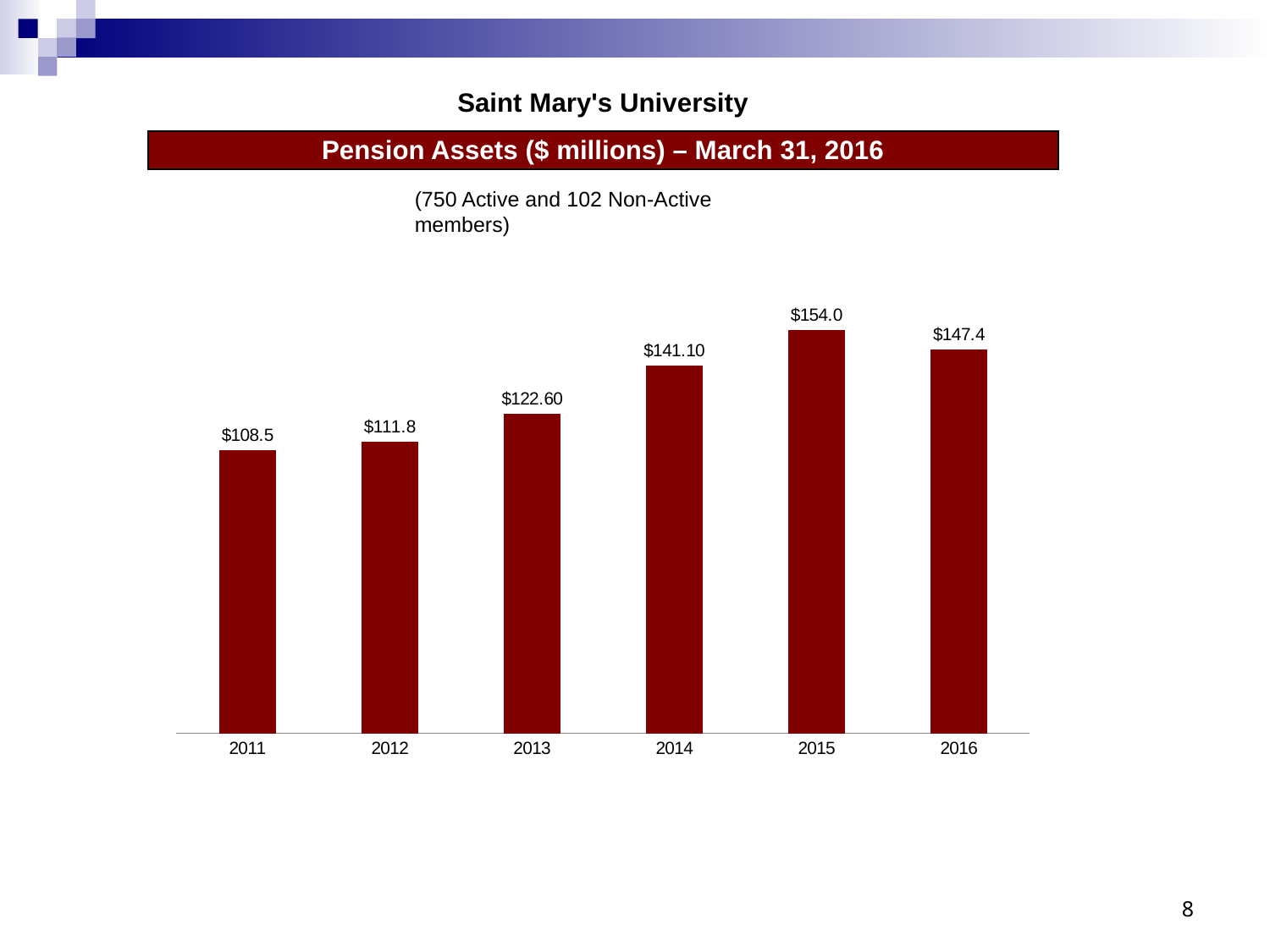
What is the difference between the pension asset values for 2015 and 2016? $6.6 Which year has a larger pension asset value, 2014 or 2016? 2016 What is the title of the chart? Pension Assets ($ millions) – March 31, 2016 What is the pension asset value shown for 2014? $141.10 How many years are shown on the chart? 6 Which year has the lowest pension asset value? 2011 Do the pension asset values rise or fall from 2011 to 2015? Rise Which year has the highest pension asset value? 2015 What kind of chart is shown on the slide? Bar chart What is the difference between the pension asset values for 2013 and 2012? $10.80 What is the pension asset value shown for 2016? $147.4 What is the pension asset value shown for 2011? $108.5